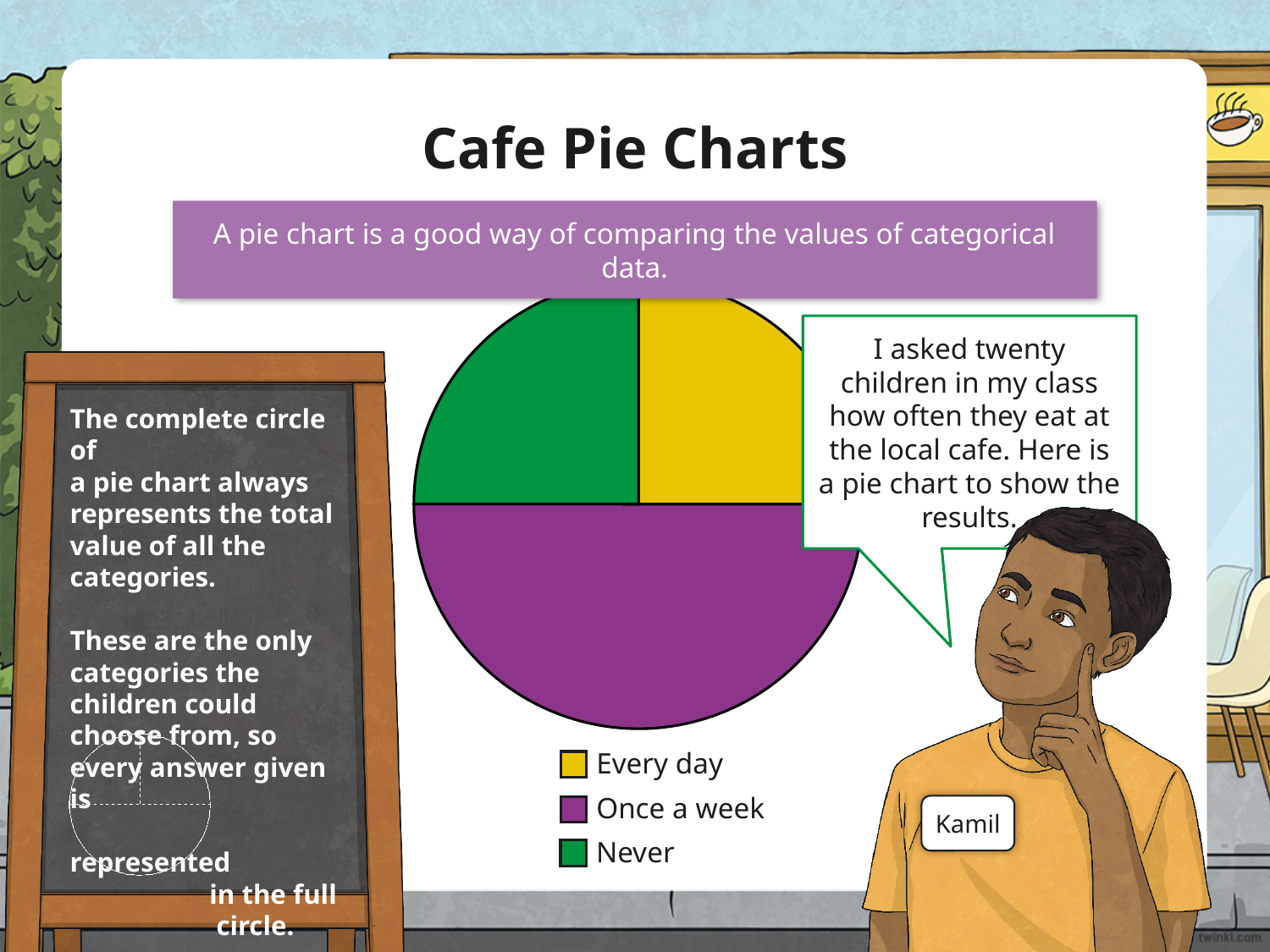
What kind of chart is shown on the slide? pie chart Which category is shown in yellow in the pie chart? Every day Which slice is larger, Once a week or Never? Once a week What colour represents the Never category in the pie chart? green How many categories does the pie chart show? 3 Which category has the largest slice of the pie chart? Once a week Which slice is larger, Once a week or Every day? Once a week How many entries does the legend of the pie chart list? 3